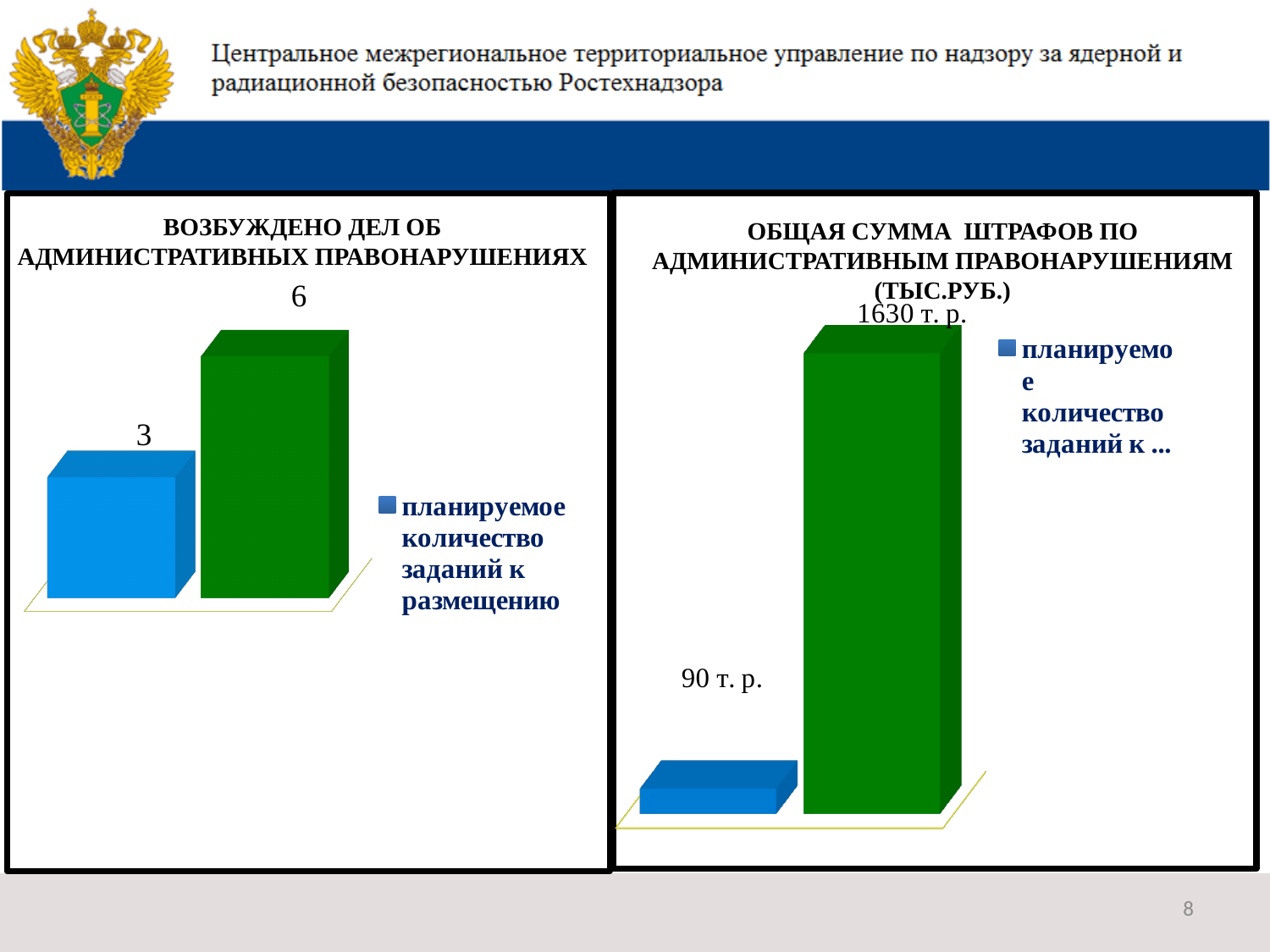
What unit is given in the title of the right chart (ОБЩАЯ СУММА ШТРАФОВ ПО АДМИНИСТРАТИВНЫМ ПРАВОНАРУШЕНИЯМ)? ТЫС.РУБ. In the right chart (ОБЩАЯ СУММА ШТРАФОВ ПО АДМИНИСТРАТИВНЫМ ПРАВОНАРУШЕНИЯМ), what value is labelled on the green bar? 1630 т. р. In the right chart (ОБЩАЯ СУММА ШТРАФОВ ПО АДМИНИСТРАТИВНЫМ ПРАВОНАРУШЕНИЯМ), what value is labelled on the blue bar? 90 т. р. In the left chart (ВОЗБУЖДЕНО ДЕЛ ОБ АДМИНИСТРАТИВНЫХ ПРАВОНАРУШЕНИЯХ), what is the difference between the green bar and the blue bar? 3 In the left chart (ВОЗБУЖДЕНО ДЕЛ ОБ АДМИНИСТРАТИВНЫХ ПРАВОНАРУШЕНИЯХ), what value is shown on the blue bar? 3 What kind of chart is the left chart (ВОЗБУЖДЕНО ДЕЛ ОБ АДМИНИСТРАТИВНЫХ ПРАВОНАРУШЕНИЯХ)? bar chart In the right chart (ОБЩАЯ СУММА ШТРАФОВ ПО АДМИНИСТРАТИВНЫМ ПРАВОНАРУШЕНИЯМ), what is the difference between the green bar and the blue bar? 1540 т. р. How many bars are plotted in the left chart (ВОЗБУЖДЕНО ДЕЛ ОБ АДМИНИСТРАТИВНЫХ ПРАВОНАРУШЕНИЯХ)? 2 How many entries does the legend of the left chart (ВОЗБУЖДЕНО ДЕЛ ОБ АДМИНИСТРАТИВНЫХ ПРАВОНАРУШЕНИЯХ) list? 1 In the right chart (ОБЩАЯ СУММА ШТРАФОВ ПО АДМИНИСТРАТИВНЫМ ПРАВОНАРУШЕНИЯМ), which bar shows the lowest value? the blue bar (90 т. р.) In the left chart (ВОЗБУЖДЕНО ДЕЛ ОБ АДМИНИСТРАТИВНЫХ ПРАВОНАРУШЕНИЯХ), which bar is higher, the blue one or the green one? the green one In the left chart (ВОЗБУЖДЕНО ДЕЛ ОБ АДМИНИСТРАТИВНЫХ ПРАВОНАРУШЕНИЯХ), what value is shown on the green bar? 6